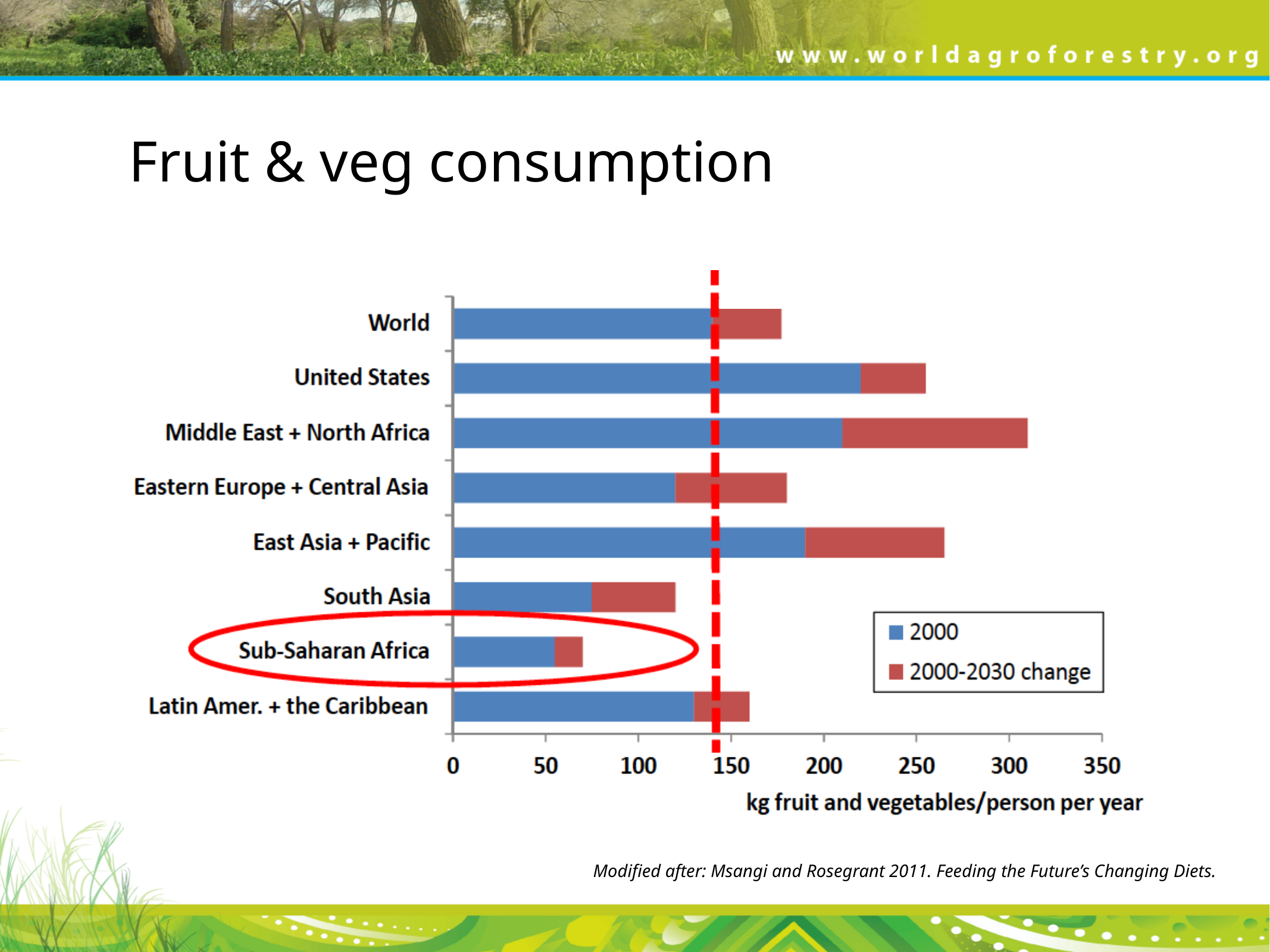
How many series does the legend list? 2 Which region has the shortest total bar? Sub-Saharan Africa Which has the longer total bar, Sub-Saharan Africa or Latin Amer. + the Caribbean? Latin Amer. + the Caribbean Which has the larger 2000 value, United States or South Asia? United States How many regions (categories) are plotted in the chart? 8 Is the 2000 value for Sub-Saharan Africa greater or less than 100? less Is the 2000 value for United States greater or less than 200? greater Which region has the longest total bar (2000 plus 2000-2030 change)? Middle East + North Africa Is the total bar for South Asia greater or less than 150? less What kind of chart is shown on the slide? bar chart What is the label of the x axis? kg fruit and vegetables/person per year Which region has the largest 2000-2030 change segment? Middle East + North Africa